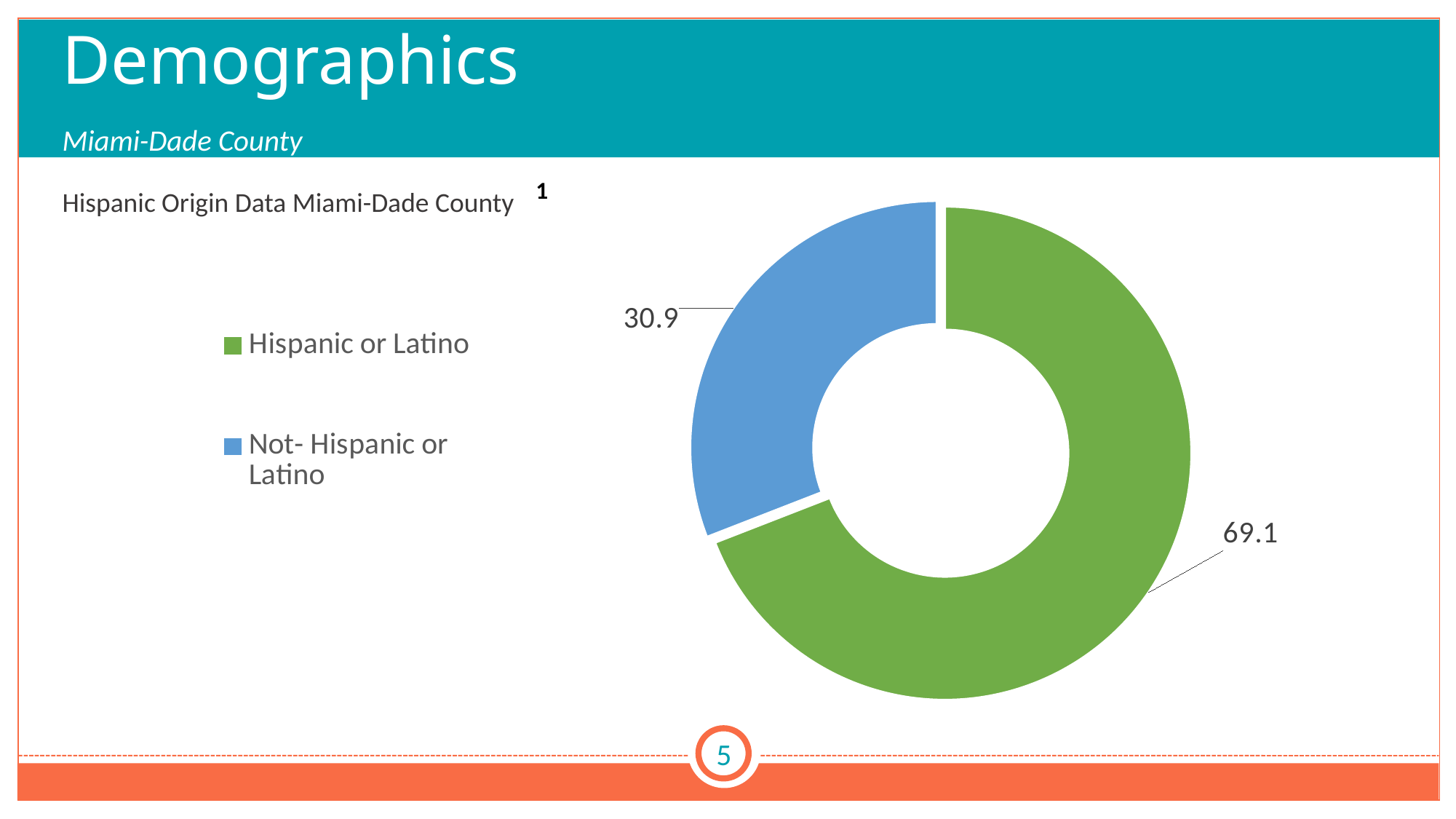
What is the value for Hispanic or Latino? 69.1 What is the value for Not- Hispanic or Latino? 30.9 Which category has the smallest slice? Not- Hispanic or Latino Which category has the largest slice? Hispanic or Latino What colour is the Hispanic or Latino slice? Green How many entries does the legend list? 2 What is the total of the two values shown on the chart? 100 Which is larger, the Hispanic or Latino slice or the Not- Hispanic or Latino slice? Hispanic or Latino How many categories does the chart show? 2 What kind of chart is shown on the slide? Doughnut chart What is the title of the chart? Hispanic Origin Data Miami-Dade County What is the difference between the Hispanic or Latino value and the Not- Hispanic or Latino value? 38.2